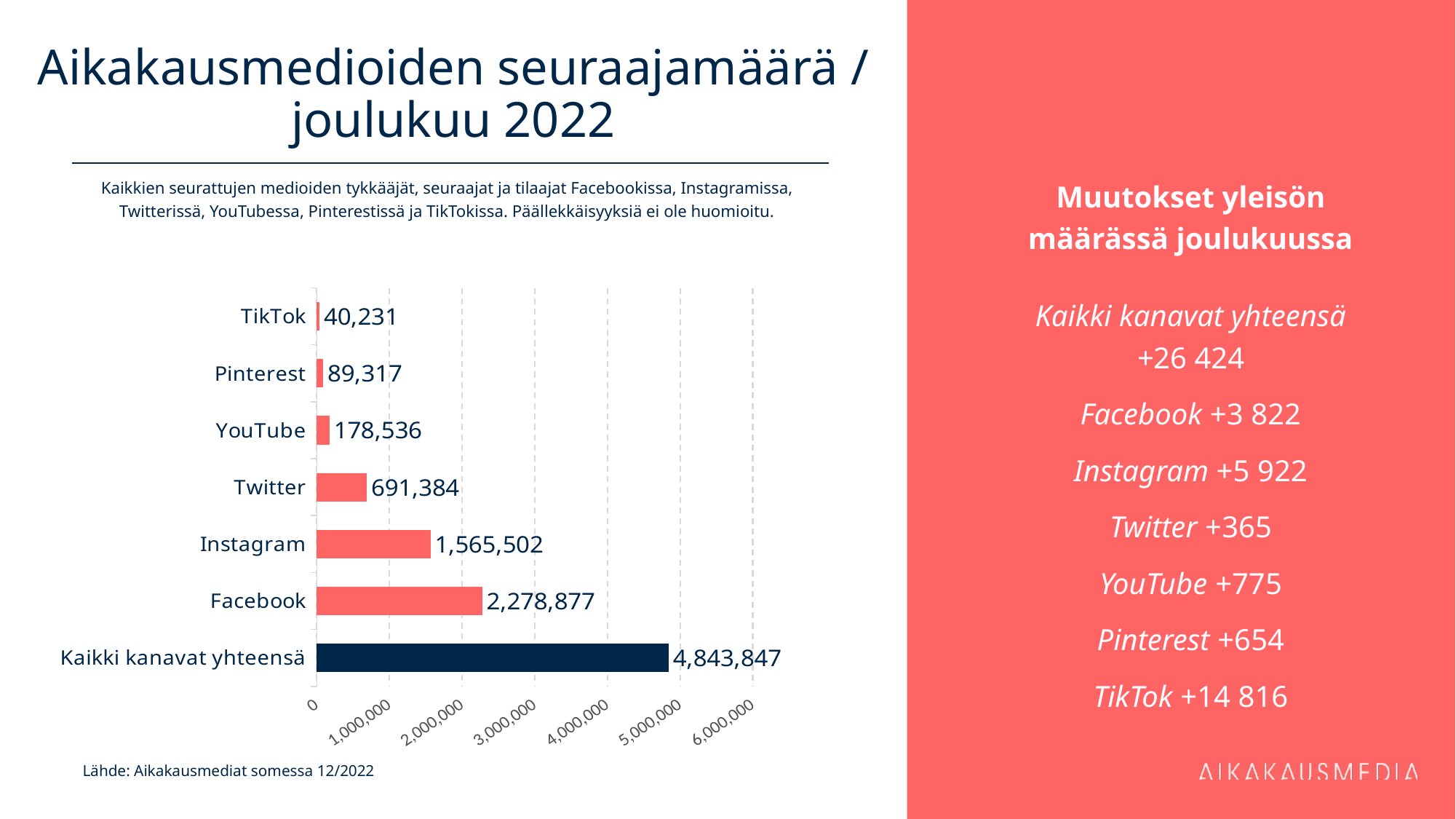
What is the value shown for Kaikki kanavat yhteensä? 4,843,847 Which individual channel (excluding the total) has the highest value? Facebook What is the title of the slide containing the chart? Aikakausmedioiden seuraajamäärä / joulukuu 2022 What is the difference between the Facebook and Instagram values? 713,375 What is the value shown for Instagram? 1,565,502 What kind of chart is shown on the slide? Bar chart How many categories are shown in the chart? 7 Which is larger, the value for Pinterest or the value for YouTube? YouTube What is the value shown for Facebook? 2,278,877 Which category has the lowest value? TikTok What is the difference between the Twitter and YouTube values? 512,848 What is the value shown for TikTok? 40,231